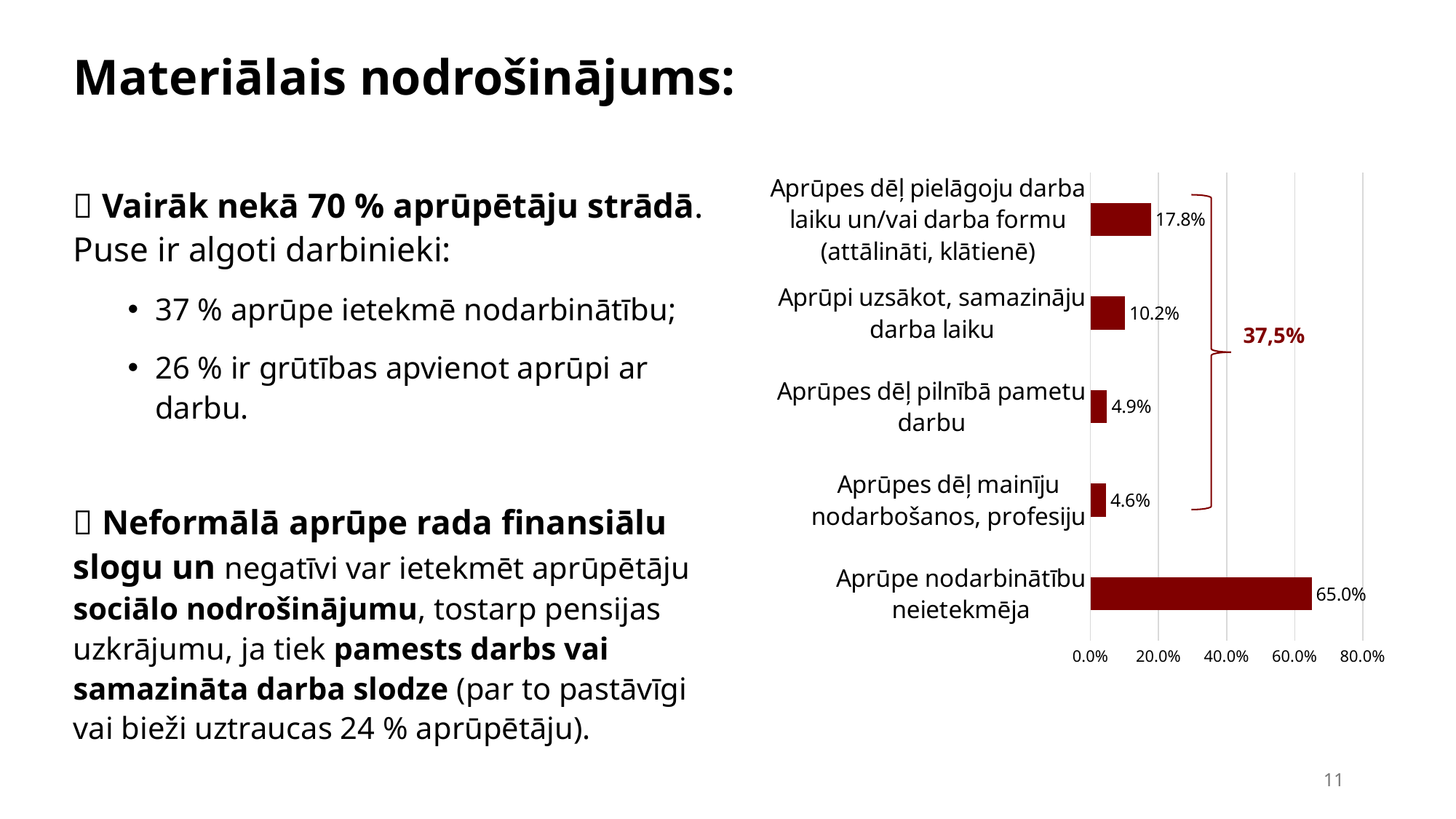
What combined percentage is shown next to the bracket grouping the top four bars? 37,5% Which category has the highest value? Aprūpe nodarbinātību neietekmēja What is the value for "Aprūpes dēļ pielāgoju darba laiku un/vai darba formu (attālināti, klātienē)"? 17.8% What kind of chart is shown on the slide? bar chart Which category has the lowest value? Aprūpes dēļ mainīju nodarbošanos, profesiju What is the value for "Aprūpes dēļ mainīju nodarbošanos, profesiju"? 4.6% How many categories are shown in the chart? 5 Which is larger: the value for "Aprūpes dēļ pilnībā pametu darbu" or for "Aprūpi uzsākot, samazināju darba laiku"? Aprūpi uzsākot, samazināju darba laiku What is the difference between the values for "Aprūpes dēļ pielāgoju darba laiku un/vai darba formu (attālināti, klātienē)" and "Aprūpi uzsākot, samazināju darba laiku"? 7.6% What is the value for "Aprūpi uzsākot, samazināju darba laiku"? 10.2% What is the value for "Aprūpe nodarbinātību neietekmēja"? 65.0% Is the value for "Aprūpe nodarbinātību neietekmēja" greater or less than 60.0%? greater